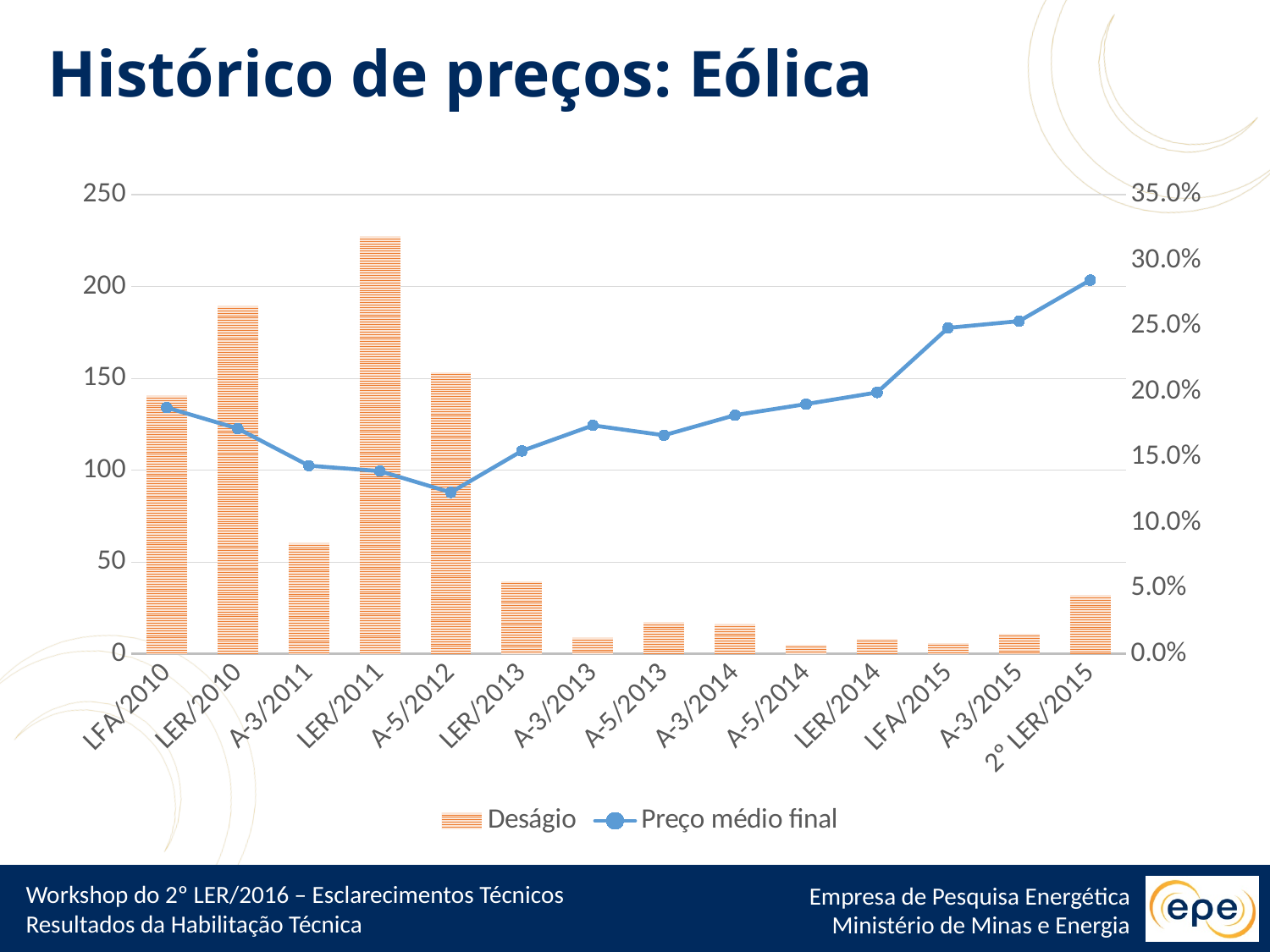
Which auction has the highest Deságio bar? LER/2011 How many series does the legend list? 2 What kind of chart is shown on the slide? A combined bar and line chart Which auction has the highest Preço médio final? 2° LER/2015 Which auction has the lowest Preço médio final? A-5/2012 How many auctions (categories) are shown on the x axis? 14 Which has the higher Preço médio final, LFA/2010 or A-5/2012? LFA/2010 Does the Preço médio final generally rise or fall from A-5/2012 to 2° LER/2015? rise Which has the larger Deságio, LER/2010 or A-5/2012? LER/2010